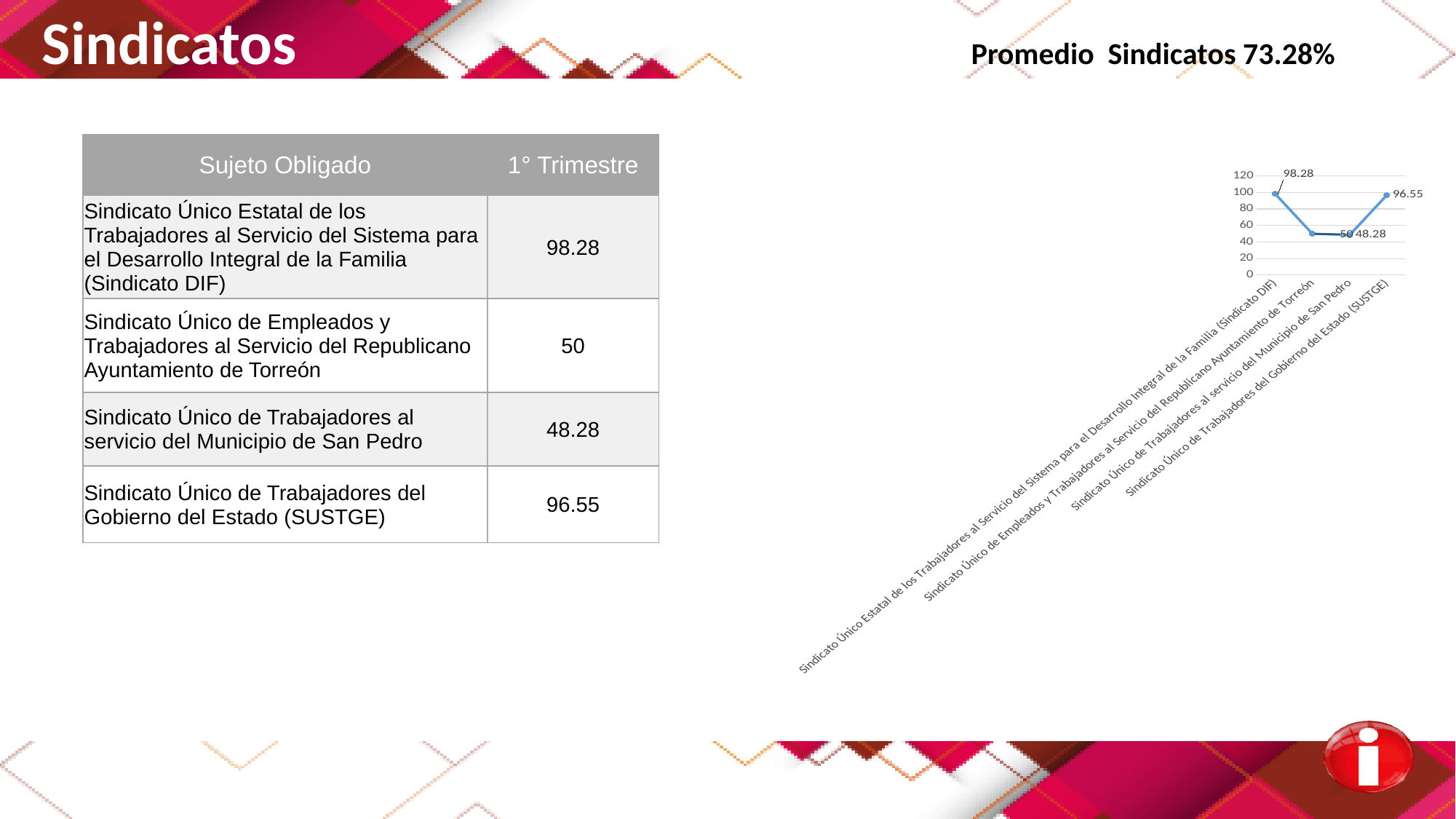
What is the highest value shown on the chart's vertical axis? 120 What is the value for Sindicato Único de Trabajadores al servicio del Municipio de San Pedro? 48.28 What is the difference between the values for Sindicato DIF and SUSTGE? 1.73 What kind of chart is shown on the slide? line chart Which category has the lowest value on the chart? Sindicato Único de Trabajadores al servicio del Municipio de San Pedro Is the value for Sindicato Único de Trabajadores del Gobierno del Estado (SUSTGE) greater or less than 80? greater Which is larger, the value for the Ayuntamiento de Torreón union or the Municipio de San Pedro union? Ayuntamiento de Torreón What is the value for Sindicato Único Estatal de los Trabajadores al Servicio del Sistema para el Desarrollo Integral de la Familia (Sindicato DIF)? 98.28 What is the value for Sindicato Único de Empleados y Trabajadores al Servicio del Republicano Ayuntamiento de Torreón? 50 What is the value for Sindicato Único de Trabajadores del Gobierno del Estado (SUSTGE)? 96.55 Which category has the highest value on the chart? Sindicato Único Estatal de los Trabajadores al Servicio del Sistema para el Desarrollo Integral de la Familia (Sindicato DIF) How many data points are plotted on the line chart? 4